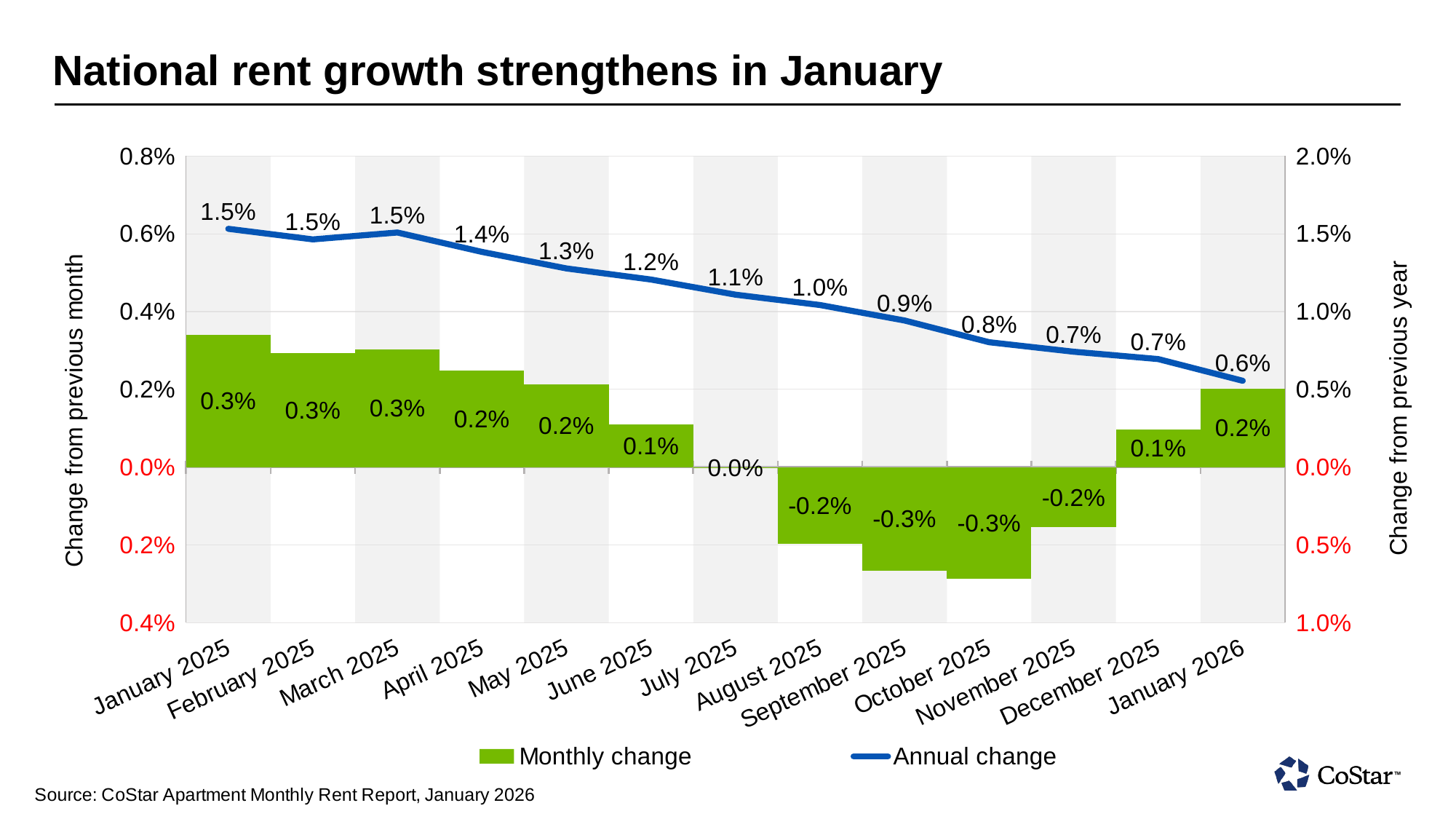
Does the annual change rise or fall from January 2025 to January 2026? Fall Which is larger, the monthly change for August 2025 or for December 2025? December 2025 What is the annual change for January 2026? 0.6% What kind of chart is this? Combination bar and line chart How many months are shown on the x axis? 13 How many series does the legend list? 2 What is the monthly change for September 2025? -0.3% Which month has the lowest annual change? January 2026 What is the annual change for October 2025? 0.8% What is the difference between the annual change in January 2025 and January 2026? 0.9% What is the monthly change for January 2026? 0.2% What is the title of the slide? National rent growth strengthens in January